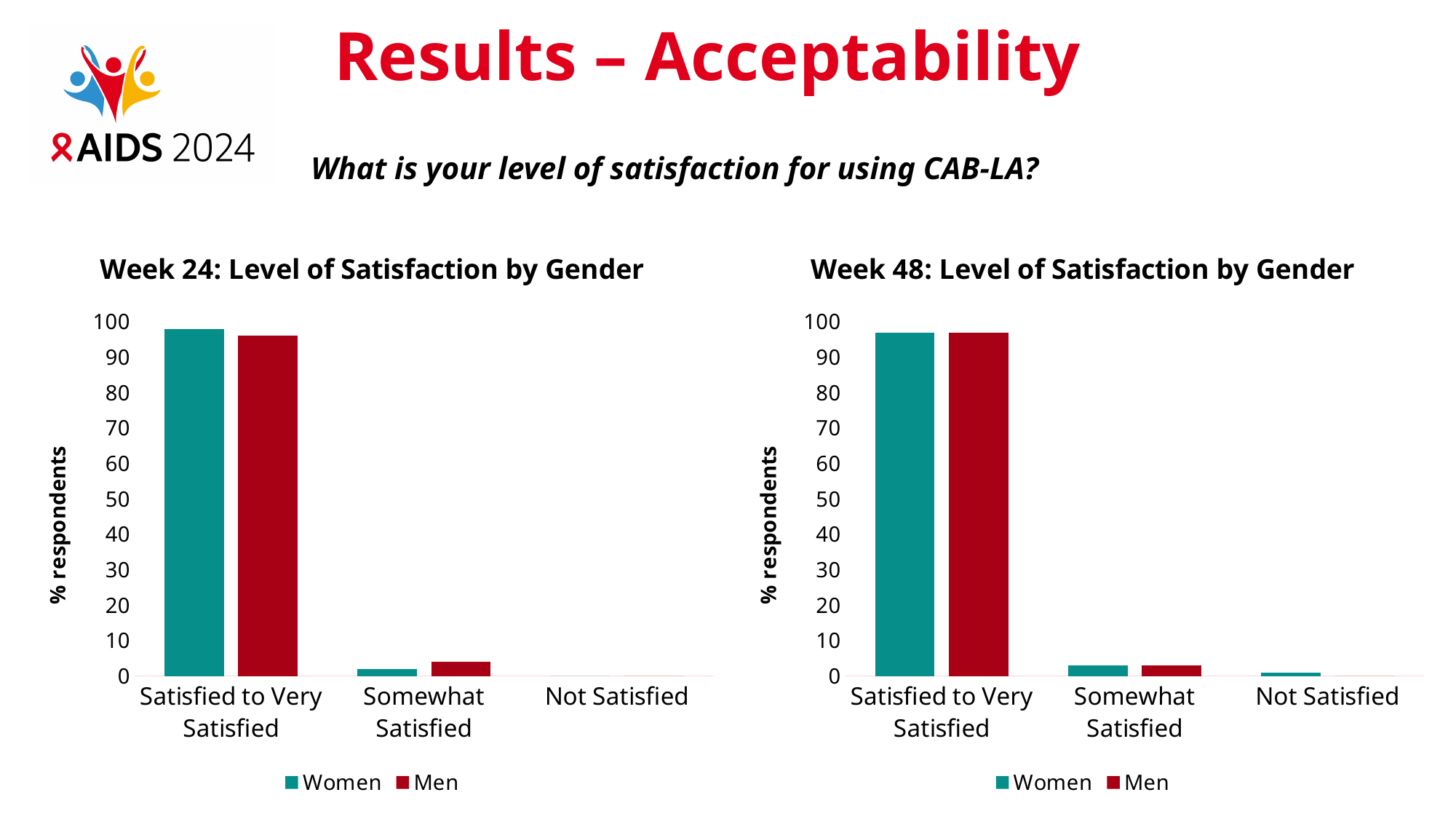
In the 'Week 48: Level of Satisfaction by Gender' chart, is the value for Women in 'Somewhat Satisfied' greater or less than 20? less What are the legend entries in the 'Week 48: Level of Satisfaction by Gender' chart? Women, Men In the 'Week 24: Level of Satisfaction by Gender' chart, how many categories are shown on the x axis? 3 In the 'Week 48: Level of Satisfaction by Gender' chart, which category has the lowest value for Men? Not Satisfied What is the y-axis label of the 'Week 48: Level of Satisfaction by Gender' chart? % respondents In the 'Week 24: Level of Satisfaction by Gender' chart, is the value for Men in 'Somewhat Satisfied' greater or less than 10? less In the 'Week 24: Level of Satisfaction by Gender' chart, is the value for Women in 'Satisfied to Very Satisfied' greater or less than 90? greater What kind of chart is the 'Week 24: Level of Satisfaction by Gender' chart? bar chart In the 'Week 24: Level of Satisfaction by Gender' chart, which category has the highest value for Women? Satisfied to Very Satisfied In the 'Week 24: Level of Satisfaction by Gender' chart, how many series does the legend list? 2 In the 'Week 24: Level of Satisfaction by Gender' chart, for 'Somewhat Satisfied', which is larger: Women or Men? Men